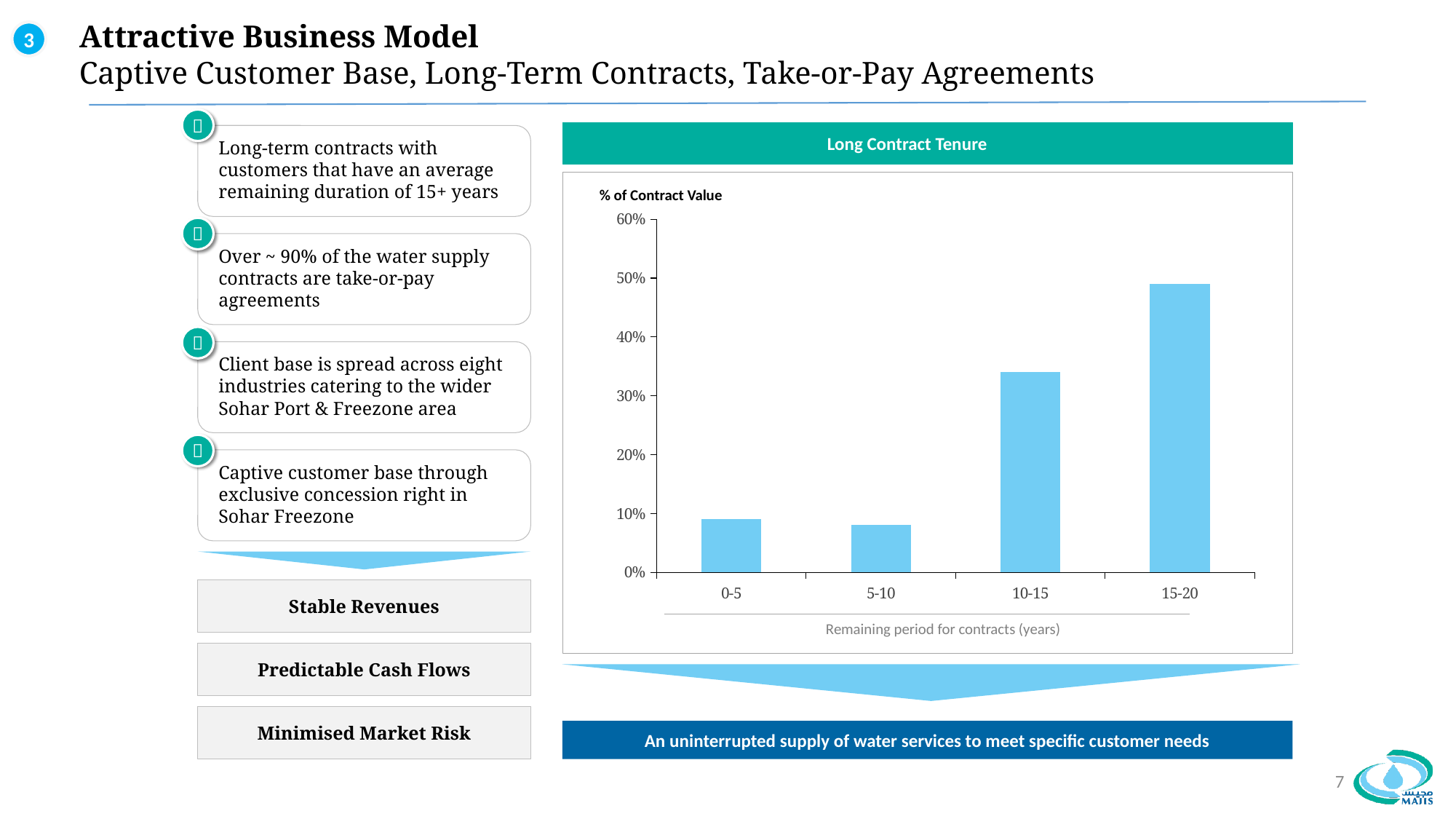
How many remaining-period categories are plotted on the x axis of the chart? 4 What is the label on the x axis of the chart? Remaining period for contracts (years) Which is larger, the value for 10-15 years or the value for 15-20 years? 15-20 Which remaining-period category has the highest % of contract value? 15-20 Which is larger, the value for 5-10 years or the value for 10-15 years? 10-15 Is the value for the 10-15 years category greater or less than 30%? greater Is the value for the 0-5 years category greater or less than 20%? less Is the value for the 15-20 years category greater or less than 40%? greater Do the values rise or fall from the 5-10 category to the 15-20 category? rise What kind of chart is shown under the heading 'Long Contract Tenure'? bar chart